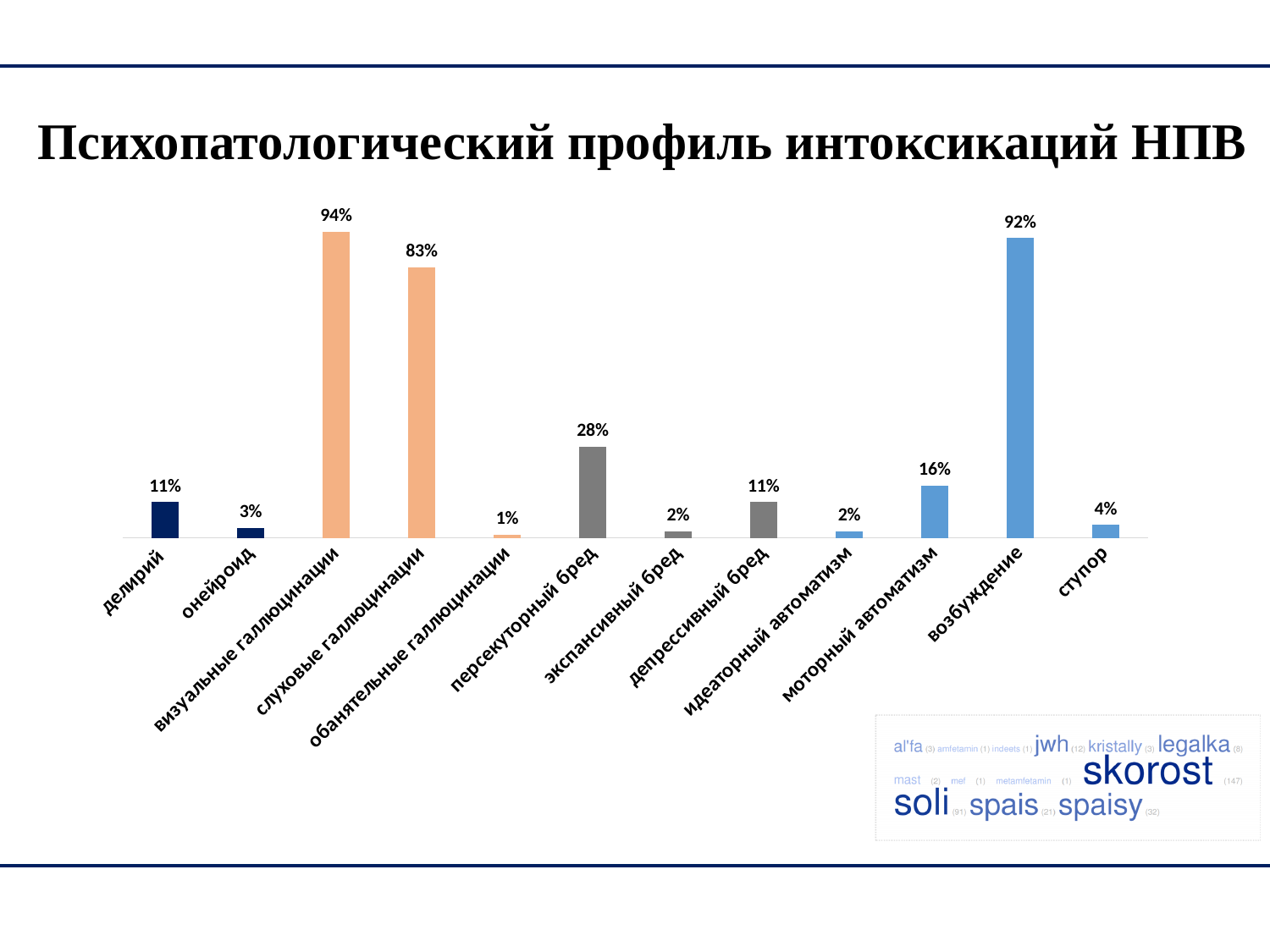
What is the title of the slide? Психопатологический профиль интоксикаций НПВ What is the difference between возбуждение and ступор? 88% What is the value for визуальные галлюцинации? 94% Which category has the lowest value? обанятельные галлюцинации What is the value for персекуторный бред? 28% What is the value for моторный автоматизм? 16% Which is larger, делирий or онейроид? делирий What kind of chart is shown on the slide? bar chart How many categories are shown in the chart? 12 What is the value for ступор? 4% What is the difference between визуальные галлюцинации and слуховые галлюцинации? 11% Which category has the highest value? визуальные галлюцинации